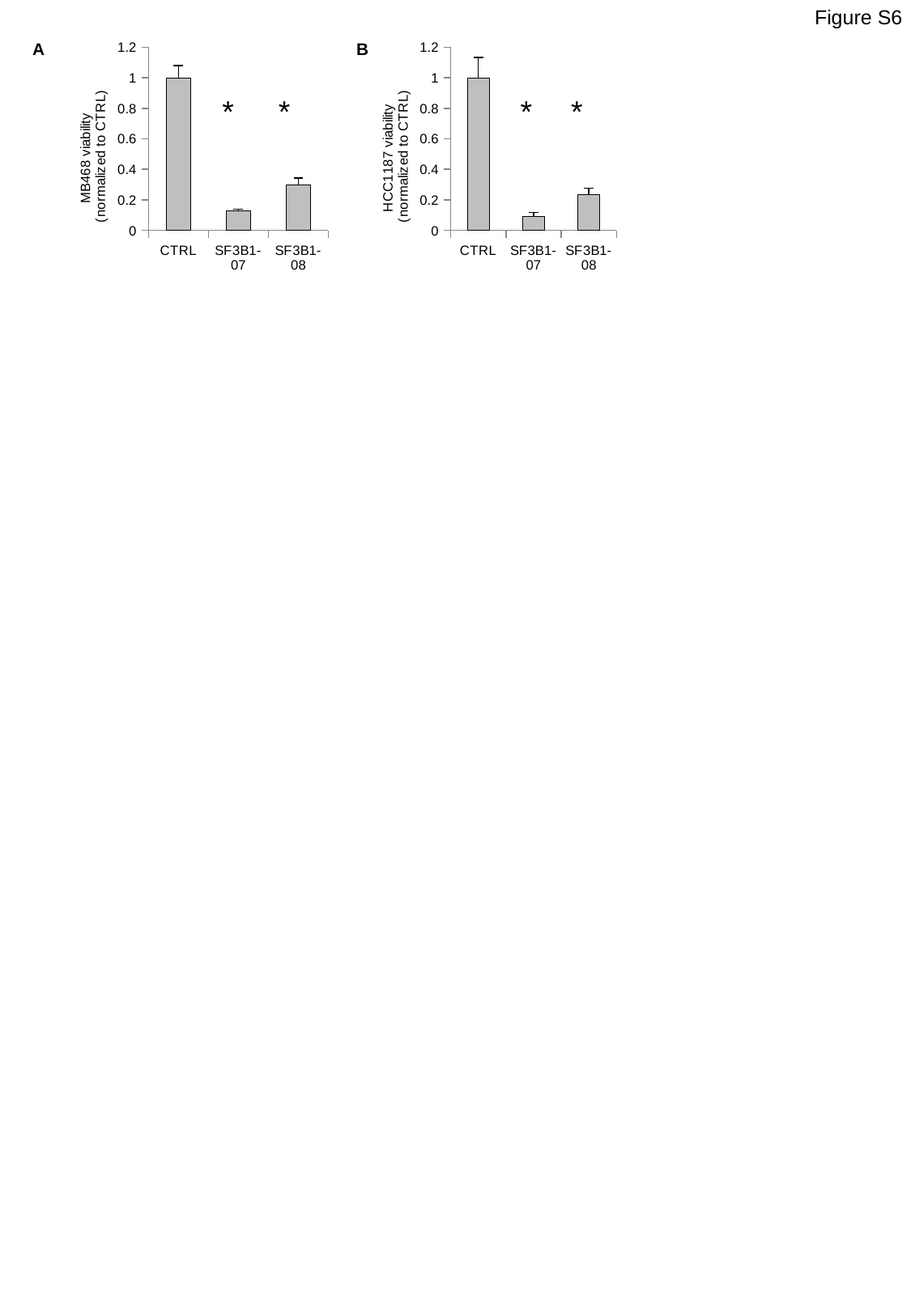
In chart B (HCC1187 viability), is the value for SF3B1-08 greater or less than 0.4? less In chart A (MB468 viability), is the value for SF3B1-08 greater or less than 0.4? less In chart B (HCC1187 viability), which category has the lowest viability? SF3B1-07 In chart A (MB468 viability), how many categories are shown on the x axis? 3 In chart A (MB468 viability), what is the value for CTRL? 1 In chart A (MB468 viability), which is larger, SF3B1-07 or SF3B1-08? SF3B1-08 In chart B (HCC1187 viability), is the value for SF3B1-07 greater or less than 0.2? less In chart A (MB468 viability), which category has the highest viability? CTRL What is the y-axis label of chart B? HCC1187 viability (normalized to CTRL) In chart A (MB468 viability), which category has the lowest viability? SF3B1-07 What kind of chart is chart A (MB468 viability)? bar chart